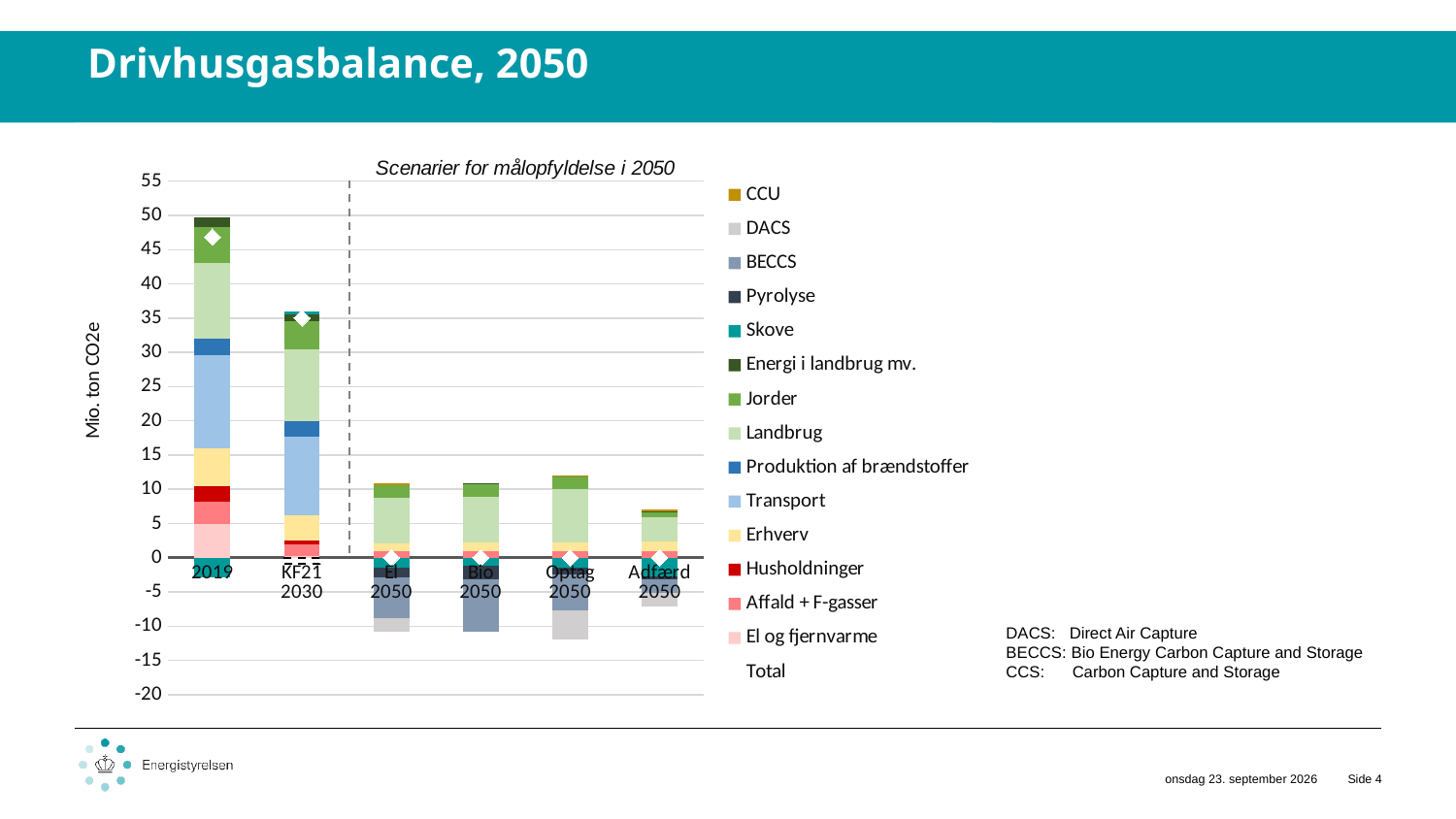
What kind of chart is shown on the slide? Stacked bar chart Is the top of the stacked bar for KF21 2030 greater or less than 30? greater Is the bottom of the stacked bar for Adfærd 2050 greater or less than -10? greater Which has the larger total, 2019 or KF21 2030? 2019 Do the total values (diamond markers) rise or fall from 2019 to the 2050 scenarios? fall How many categories are shown along the x axis of the chart? 6 Is the top of the stacked bar for 2019 greater or less than 45? greater What is the label of the y axis of the chart? Mio. ton CO2e Which category has the highest total greenhouse gas balance in the chart? 2019 What text is shown above the 2050 scenario bars in the chart? Scenarier for målopfyldelse i 2050 How many entries does the chart's legend list? 15